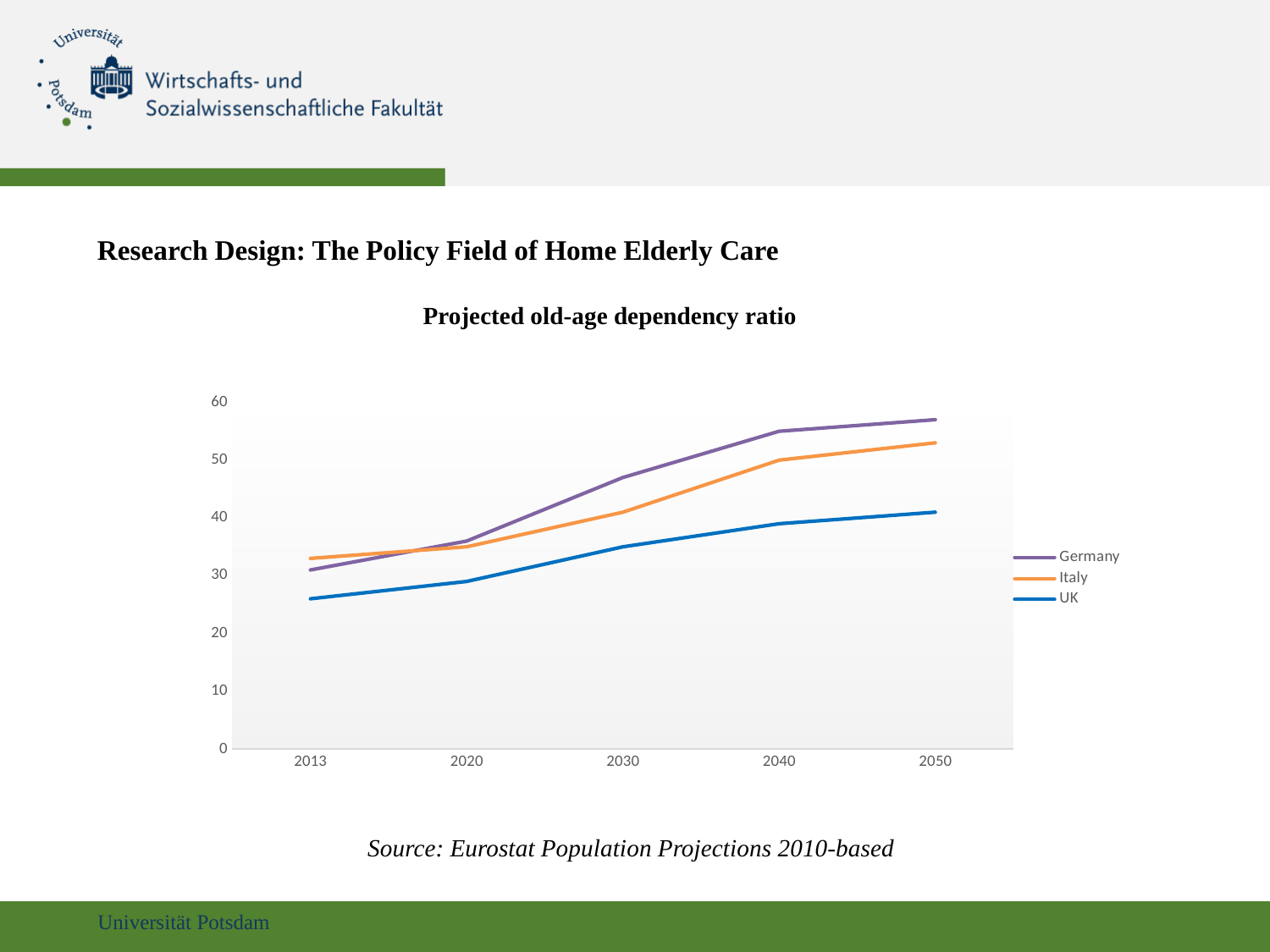
Is the value for the UK in 2030 greater or less than 40? less Is the value for the UK in 2013 greater or less than 30? less Which country has the lowest projected old-age dependency ratio in 2013? UK Which is larger in 2040, the value for Germany or the value for the UK? Germany How many series does the legend list? 3 What is the title of the chart? Projected old-age dependency ratio Which country has the highest projected old-age dependency ratio in 2050? Germany What kind of chart is shown on the slide? line chart Is the value for Germany in 2030 greater or less than 40? greater Do the values for Italy rise or fall from 2013 to 2050? rise How many years are shown on the x axis? 5